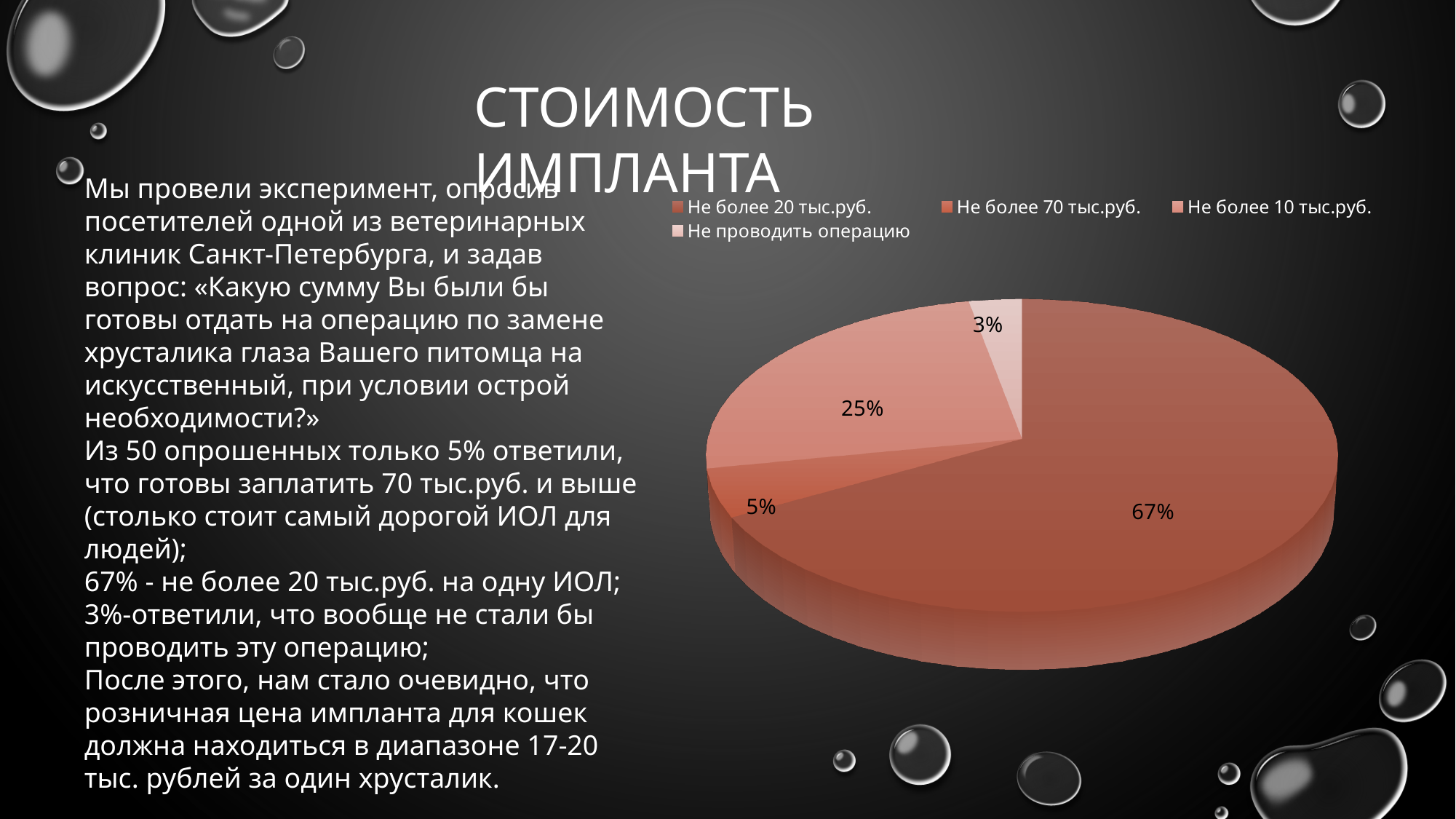
Which slice is larger: "Не более 70 тыс.руб." or "Не более 10 тыс.руб."? Не более 10 тыс.руб. What is the difference in percentage points between the "Не более 20 тыс.руб." slice and the "Не более 10 тыс.руб." slice? 42 How many slices does the pie chart have? 4 What share of the pie is labelled for "Не проводить операцию"? 3% What share of the pie is labelled for "Не более 10 тыс.руб."? 25% Which category has the smallest slice of the pie? Не проводить операцию What share of the pie is labelled for "Не более 20 тыс.руб."? 67% What kind of chart is shown on the slide? pie chart What is the title of the slide containing the pie chart? СТОИМОСТЬ ИМПЛАНТА How many entries does the chart legend list? 4 Which category has the largest slice of the pie? Не более 20 тыс.руб.